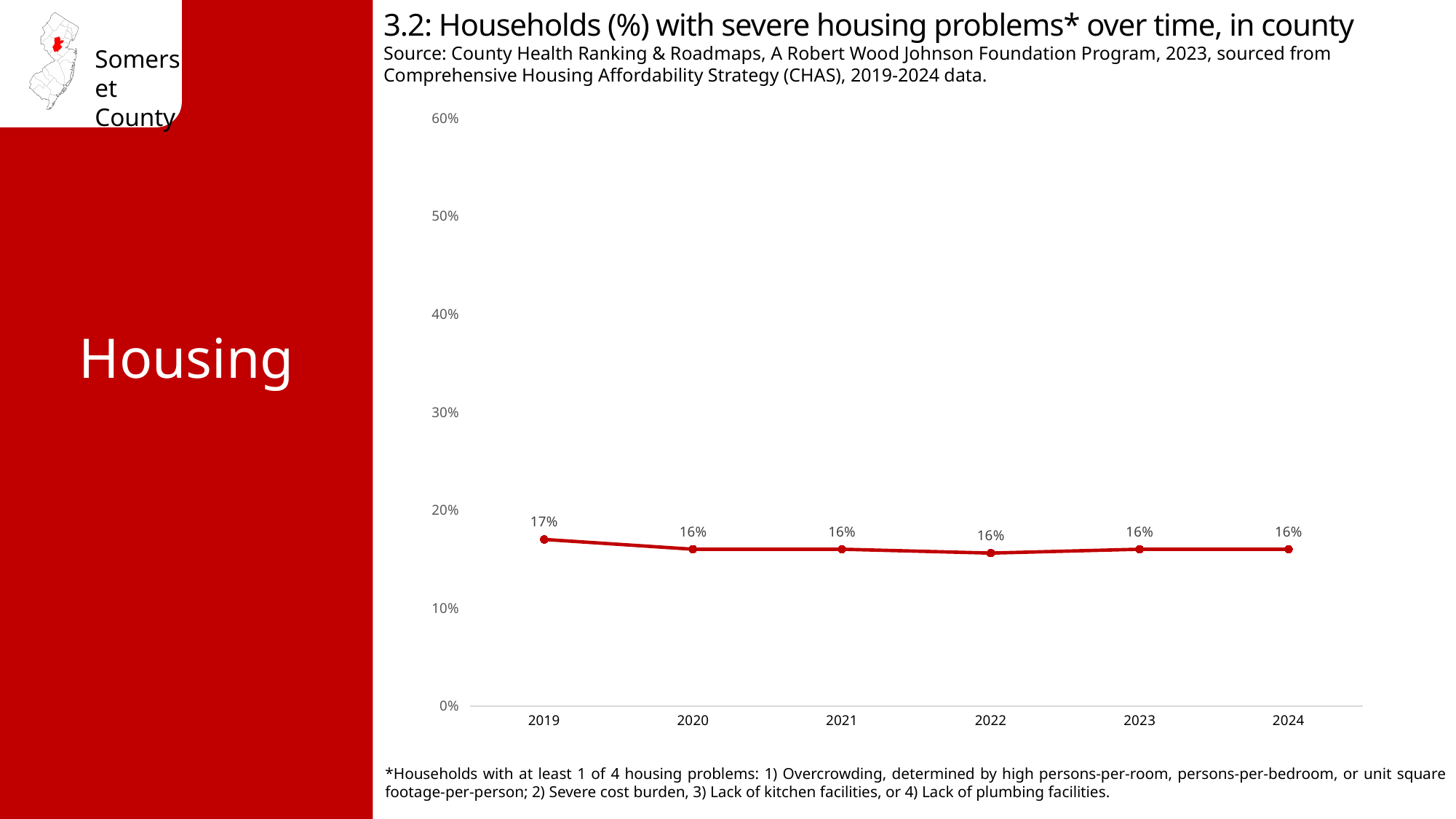
What colour is the plotted line? red What kind of chart is shown? line chart Is the value for 2023 greater or less than 10%? greater What is the difference between the 2019 value and the 2020 value? 1% What is the value for 2019? 17% How many years are plotted on the x axis? 6 Is the value for 2021 greater or less than 20%? less What is the value for 2022? 16% Do the values rise or fall from 2019 to 2020? fall Which year has the highest value? 2019 What is the value for 2024? 16% What is the title of the chart? 3.2: Households (%) with severe housing problems* over time, in county